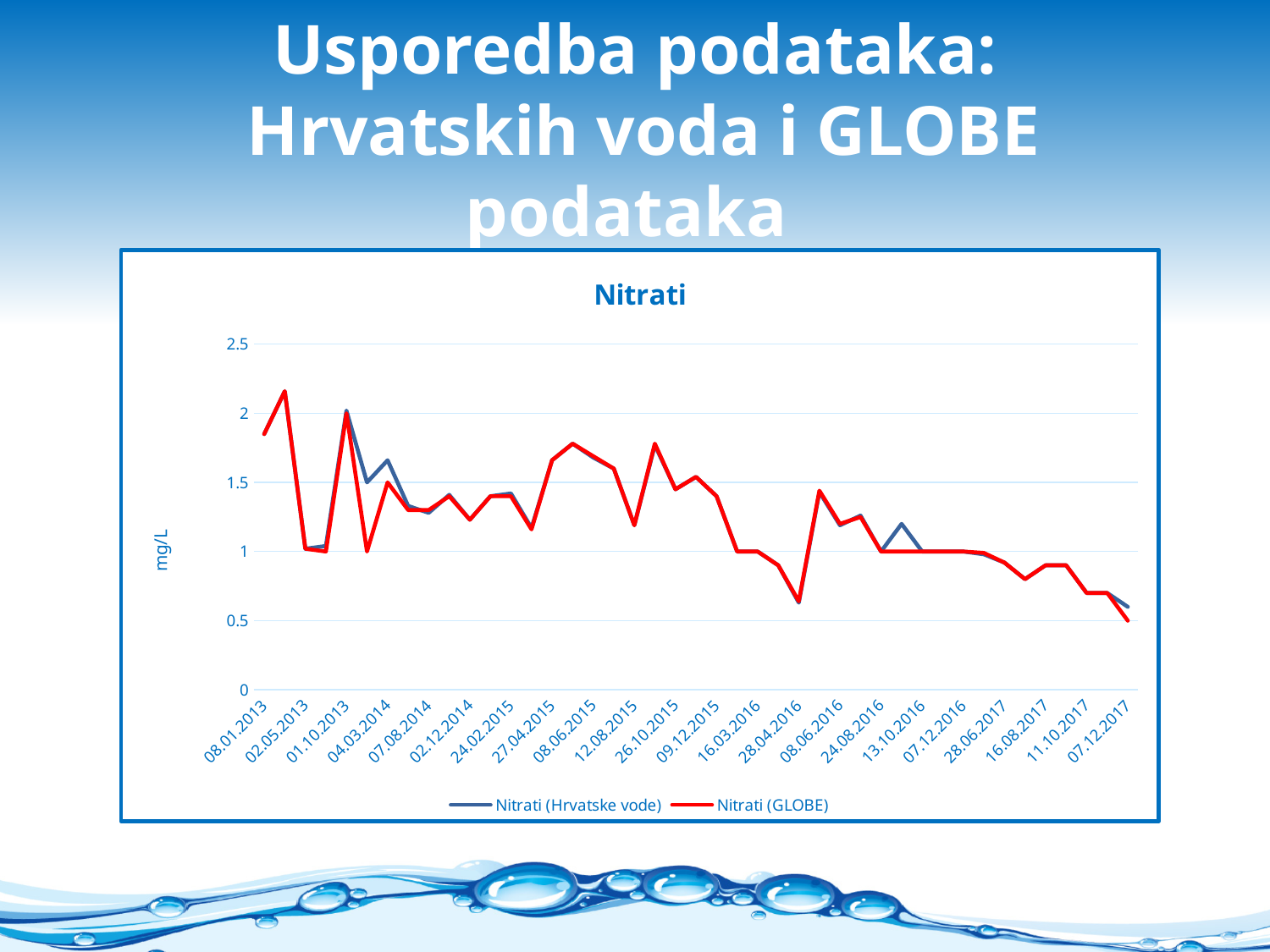
Is the value for Nitrati (GLOBE) at 08.01.2013 greater or less than 1.5? greater Is the value for Nitrati (GLOBE) at 12.08.2015 greater or less than 1.5? less What is the title of the chart? Nitrati Is the value for Nitrati (GLOBE) at 28.04.2016 greater or less than 1? less How many series does the legend of the Nitrati chart list? 2 What kind of chart is shown on the slide? line chart How many date labels are shown along the x axis of the chart? 22 What is the label on the vertical axis of the chart? mg/L Overall, do the nitrate values rise or fall from left to right along the x axis? fall For Nitrati (GLOBE), which is larger, the value at 08.01.2013 or the value at 07.12.2017? 08.01.2013